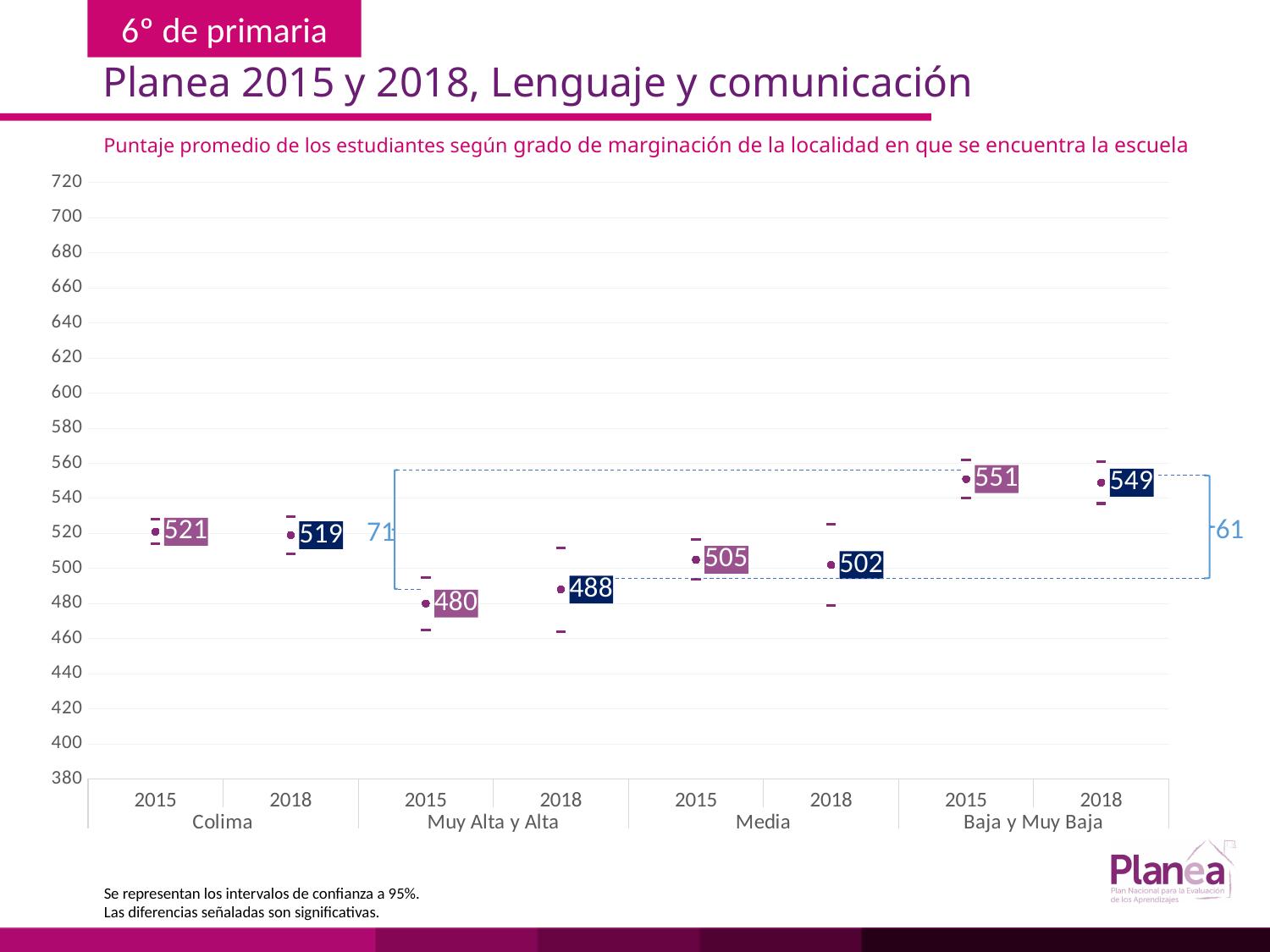
How many data points are plotted on the chart? 8 Which is larger, the 2015 score for Muy Alta y Alta or the 2018 score for Muy Alta y Alta? 2018 (488) Which group and year has the highest average score? Baja y Muy Baja, 2015 (551) What is the average score for the Muy Alta y Alta marginación group in 2018? 488 What is the subtitle of the chart? Puntaje promedio de los estudiantes según grado de marginación de la localidad en que se encuentra la escuela What is the average score for the Baja y Muy Baja marginación group in 2018? 549 What is the average score for Colima in 2015? 521 What is the difference between the 2015 scores of the Baja y Muy Baja group and the Muy Alta y Alta group? 71 What is the average score for the Media marginación group in 2015? 505 Did the average score for Colima rise or fall from 2015 to 2018? Fall Which group and year has the lowest average score? Muy Alta y Alta, 2015 (480) What is the difference between the 2018 scores of the Baja y Muy Baja group and the Muy Alta y Alta group? 61